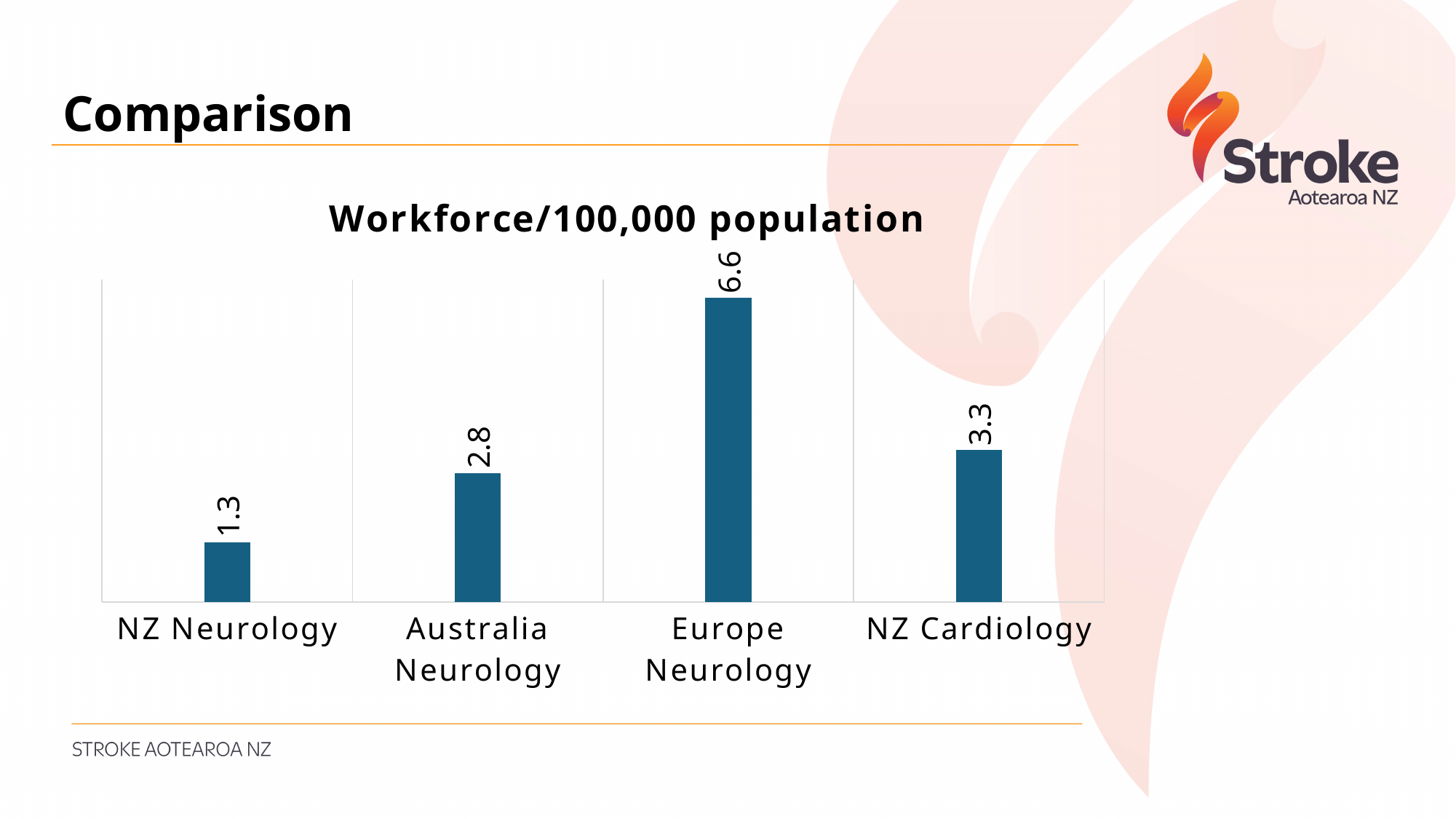
What is the value for NZ Neurology? 1.3 What is the difference between the values for NZ Cardiology and Australia Neurology? 0.5 What is the difference between the values for Europe Neurology and NZ Neurology? 5.3 How many categories are shown in the chart? 4 What is the title of the chart? Workforce/100,000 population Which category has the lowest workforce per 100,000 population? NZ Neurology Which is larger, the value for NZ Cardiology or the value for Australia Neurology? NZ Cardiology What is the value for Europe Neurology? 6.6 What is the value for Australia Neurology? 2.8 What kind of chart is shown on the slide? Bar chart Which category has the highest workforce per 100,000 population? Europe Neurology What is the value for NZ Cardiology? 3.3